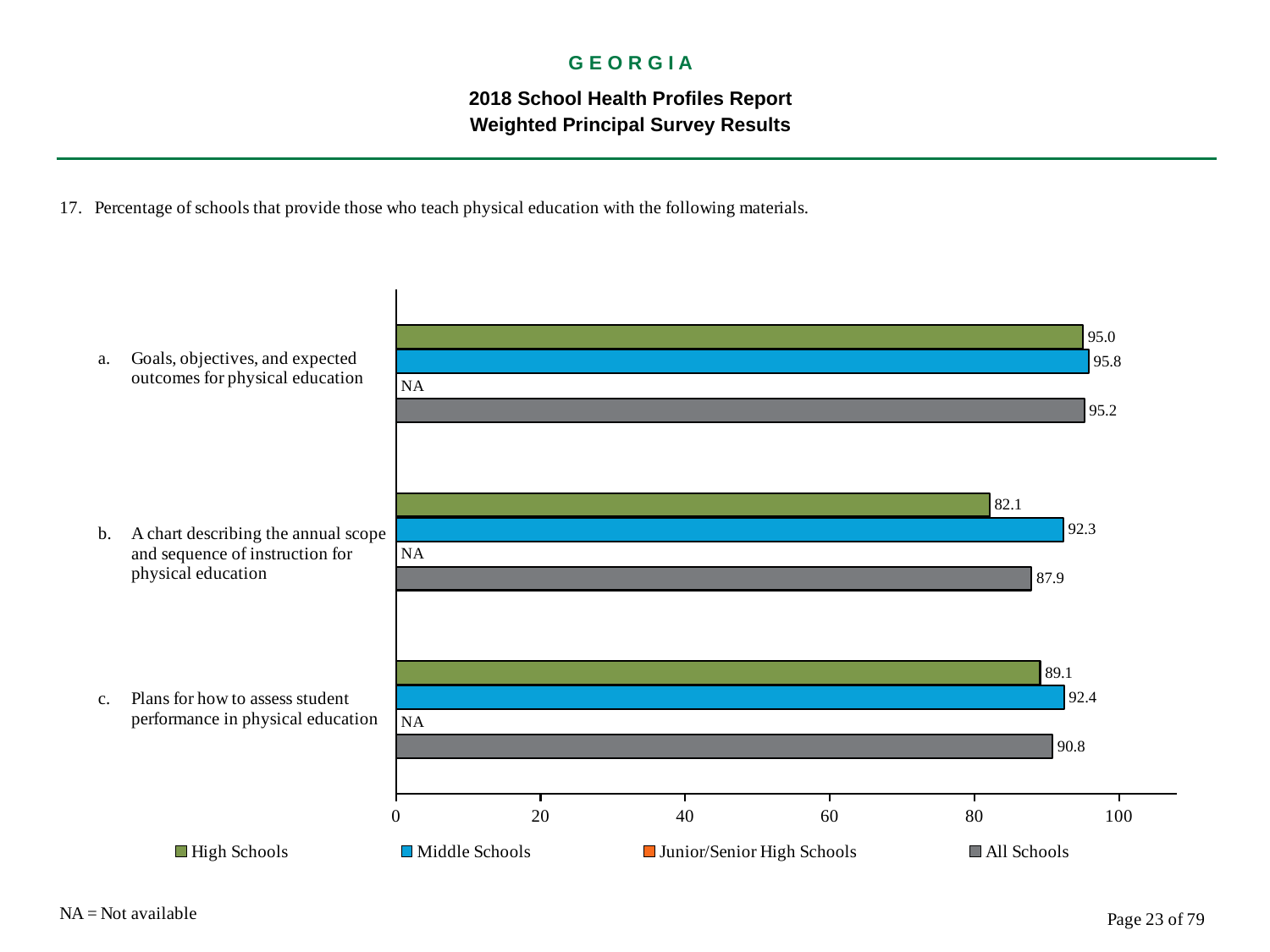
What is the value for High Schools for 'Goals, objectives, and expected outcomes for physical education'? 95.0 What is the value for All Schools for 'Plans for how to assess student performance in physical education'? 90.8 What is the difference between the Middle Schools and High Schools values for 'A chart describing the annual scope and sequence of instruction for physical education'? 10.2 Is the High Schools value for 'A chart describing the annual scope and sequence of instruction for physical education' greater or less than 80? greater For 'Plans for how to assess student performance in physical education', which is larger: the High Schools value or the Middle Schools value? Middle Schools What kind of chart is shown on the slide? Bar chart How many categories (materials) are shown on the chart? 3 How many series does the legend list? 4 Which category has the lowest High Schools value? A chart describing the annual scope and sequence of instruction for physical education Which category has the highest Middle Schools value? Goals, objectives, and expected outcomes for physical education What value is shown for Junior/Senior High Schools for 'Goals, objectives, and expected outcomes for physical education'? NA What is the value for Middle Schools for 'A chart describing the annual scope and sequence of instruction for physical education'? 92.3